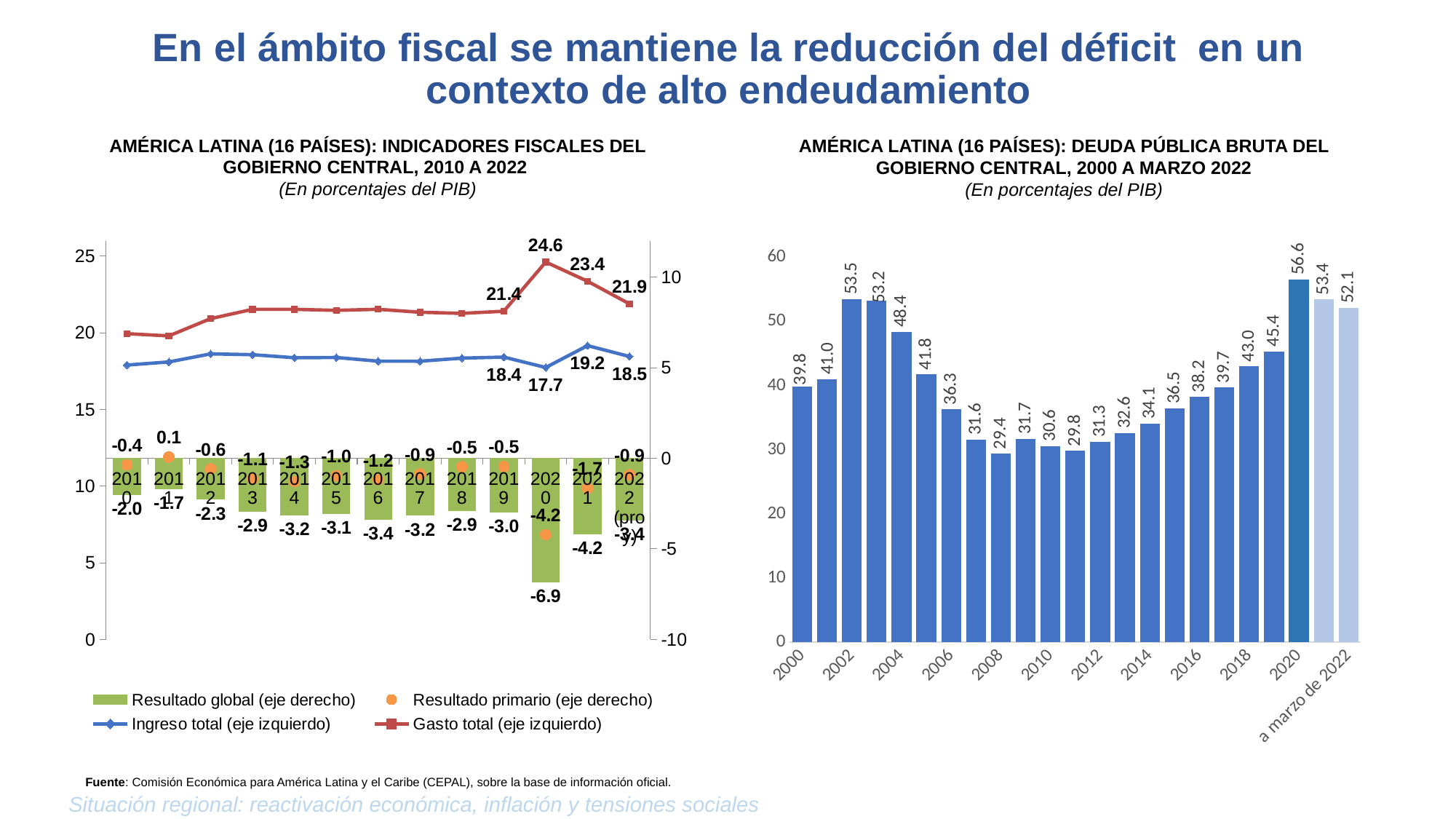
In the left-hand chart on fiscal indicators, is 'Ingreso total' higher in 2020 or in 2021? 2021 In the right-hand chart on public debt, what is the value for 'a marzo de 2022'? 52.1 In the right-hand chart on public debt, what is the difference between the 2020 value and the 2021 value? 3.2 In the right-hand chart on public debt, which year has the highest value? 2020 In the left-hand chart on fiscal indicators, by how much did 'Gasto total' fall from 2020 to 2021? 1.2 In the left-hand chart on fiscal indicators, what is the value of 'Resultado global' in 2020? -6.9 How many series does the legend of the left-hand chart on fiscal indicators list? 4 In the right-hand chart on public debt, what is the value for 2002? 53.5 What kind of chart is the right-hand chart, 'Deuda pública bruta del gobierno central, 2000 a marzo 2022'? Bar chart How many bars are plotted in the right-hand chart on public debt? 23 In the left-hand chart on fiscal indicators, what is the value of 'Gasto total' in 2020? 24.6 In the right-hand chart on public debt, what is the lowest value shown? 29.4